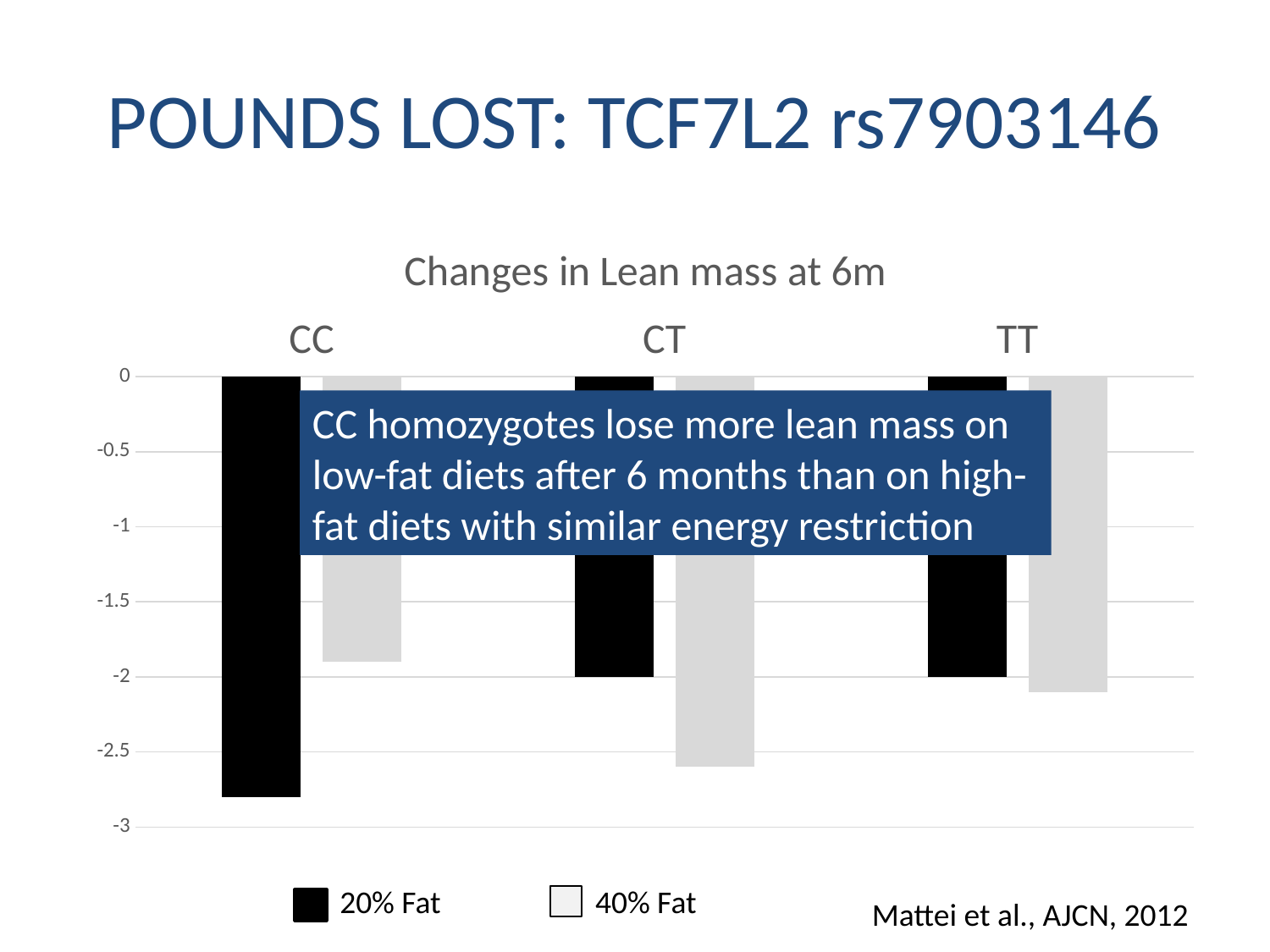
Is the 40% Fat value for CT greater or less than -2.5? less Which genotype has the lowest (most negative) 20% Fat value? CC For the CC genotype, which series shows the larger loss of lean mass, 20% Fat or 40% Fat? 20% Fat How many series does the legend list? 2 Is the 20% Fat value for CT greater or less than -2.5? greater What are the two series named in the legend? 20% Fat and 40% Fat How many genotype categories are shown on the x axis? 3 Is the 20% Fat value for CC greater or less than -2.5? less What is the title of the chart? Changes in Lean mass at 6m Which genotype has the lowest (most negative) 40% Fat value? CT What kind of chart is shown on the slide? bar chart